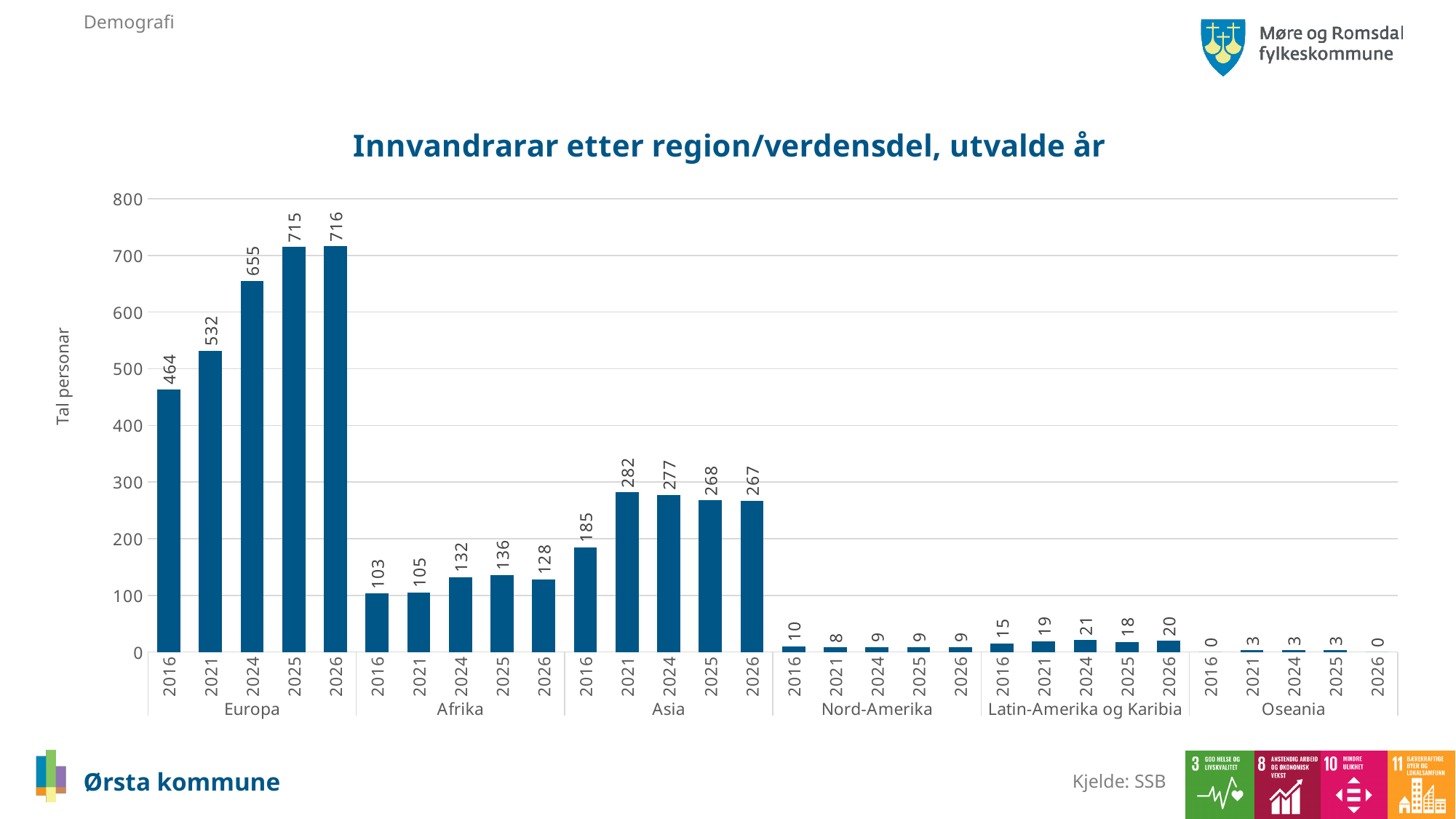
What is the value for Asia in 2016? 185 Which region has the lowest value in 2016? Oseania What is the title of the chart? Innvandrarar etter region/verdensdel, utvalde år Do the Europa values rise or fall from 2016 to 2026? Rise What is the difference between the Europa values for 2016 and 2026? 252 How many regions are shown on the x axis? 6 What is the value for Afrika in 2025? 136 Which region has the highest bar in 2026? Europa What kind of chart is this? Bar chart What is the value for Europa in 2026? 716 What is the value for Latin-Amerika og Karibia in 2024? 21 Which is larger: Afrika in 2026 or Asia in 2026? Asia in 2026